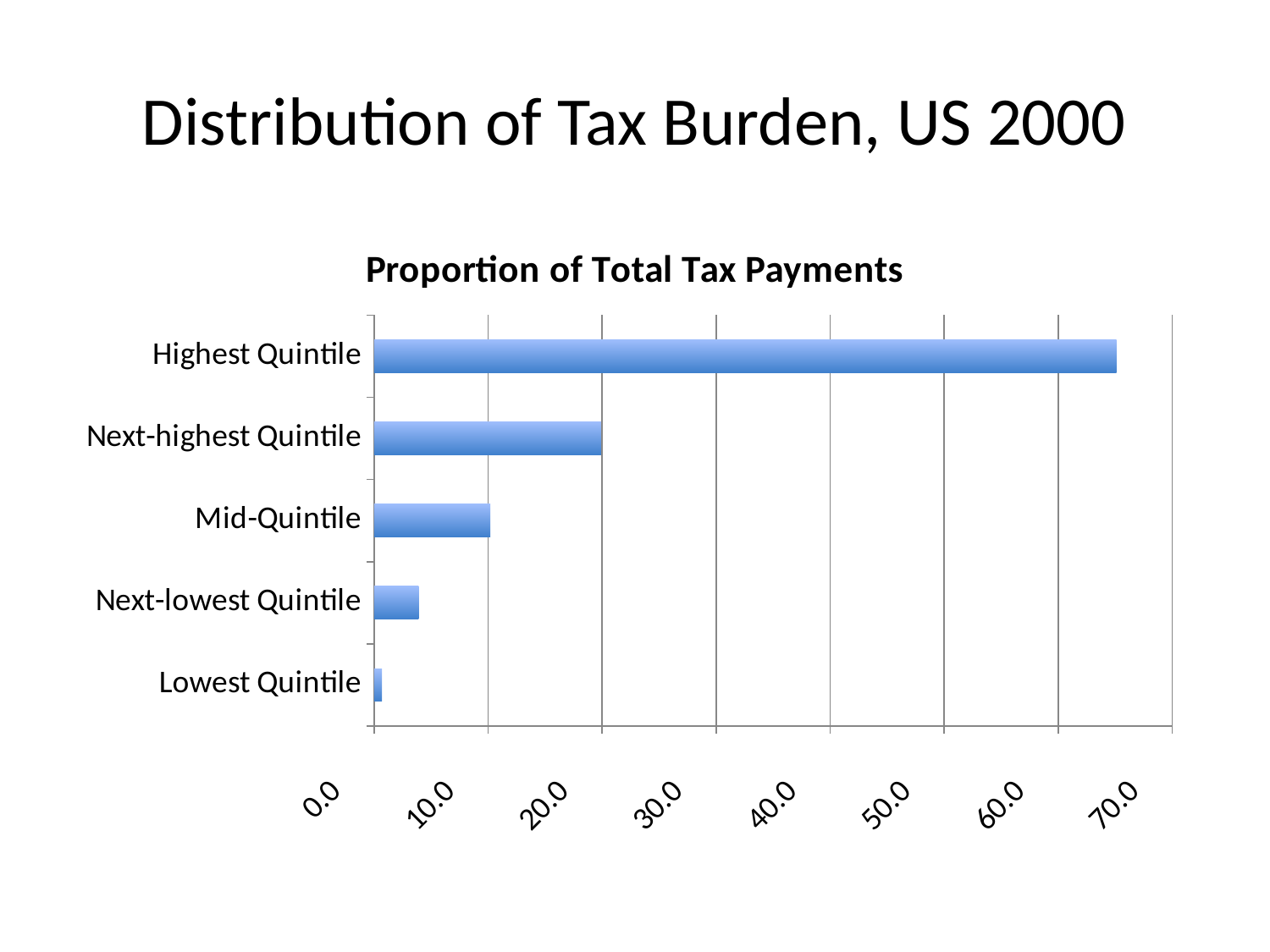
Which is larger, the value for Next-lowest Quintile or the value for Lowest Quintile? Next-lowest Quintile What is the highest value shown on the horizontal axis of the chart? 70.0 What type of chart is shown on the slide? bar chart Is the value for Lowest Quintile greater or less than 10.0? less Is the value for Highest Quintile greater or less than 60.0? greater Which quintile has the highest proportion of total tax payments? Highest Quintile Is the value for Highest Quintile greater or less than 70.0? less How many quintile categories are plotted in the chart? 5 Which quintile has the lowest proportion of total tax payments? Lowest Quintile What is the title of the chart? Proportion of Total Tax Payments Which is larger, the value for Next-highest Quintile or the value for Mid-Quintile? Next-highest Quintile